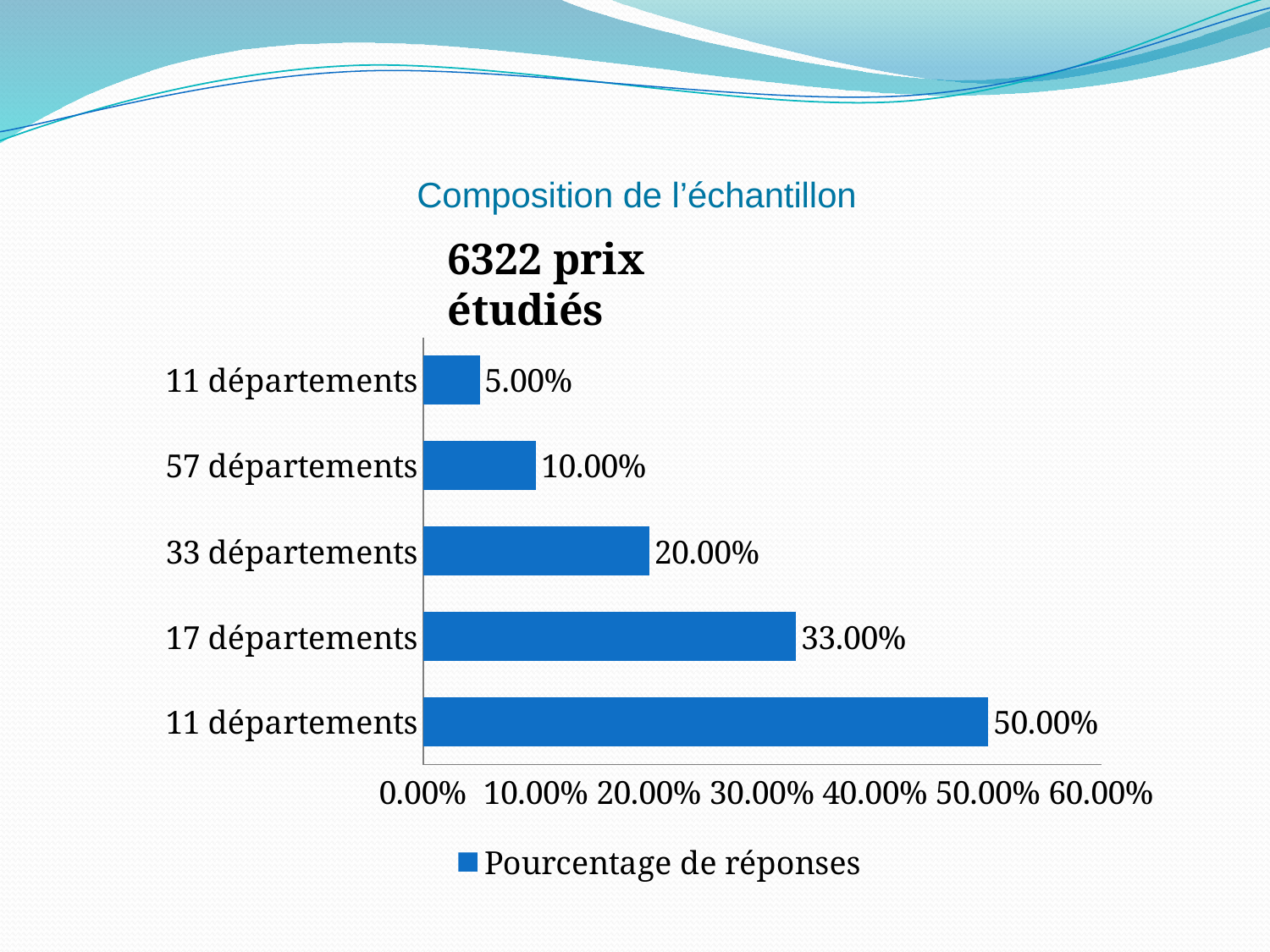
What is the value for the bottom bar, labelled 11 départements? 50.00% Which is larger, the value for 57 départements or the value for 33 départements? 33 départements What is the difference between the values for 17 départements and 33 départements? 13.00% What is the value for the top bar, labelled 11 départements? 5.00% How many series does the legend list? 1 What type of chart is shown on the slide? bar chart Which category has the highest value? 11 départements (bottom bar) How many bars are plotted in the chart? 5 What is the value for 33 départements? 20.00% What is the value for 17 départements? 33.00% What is the value for 57 départements? 10.00%